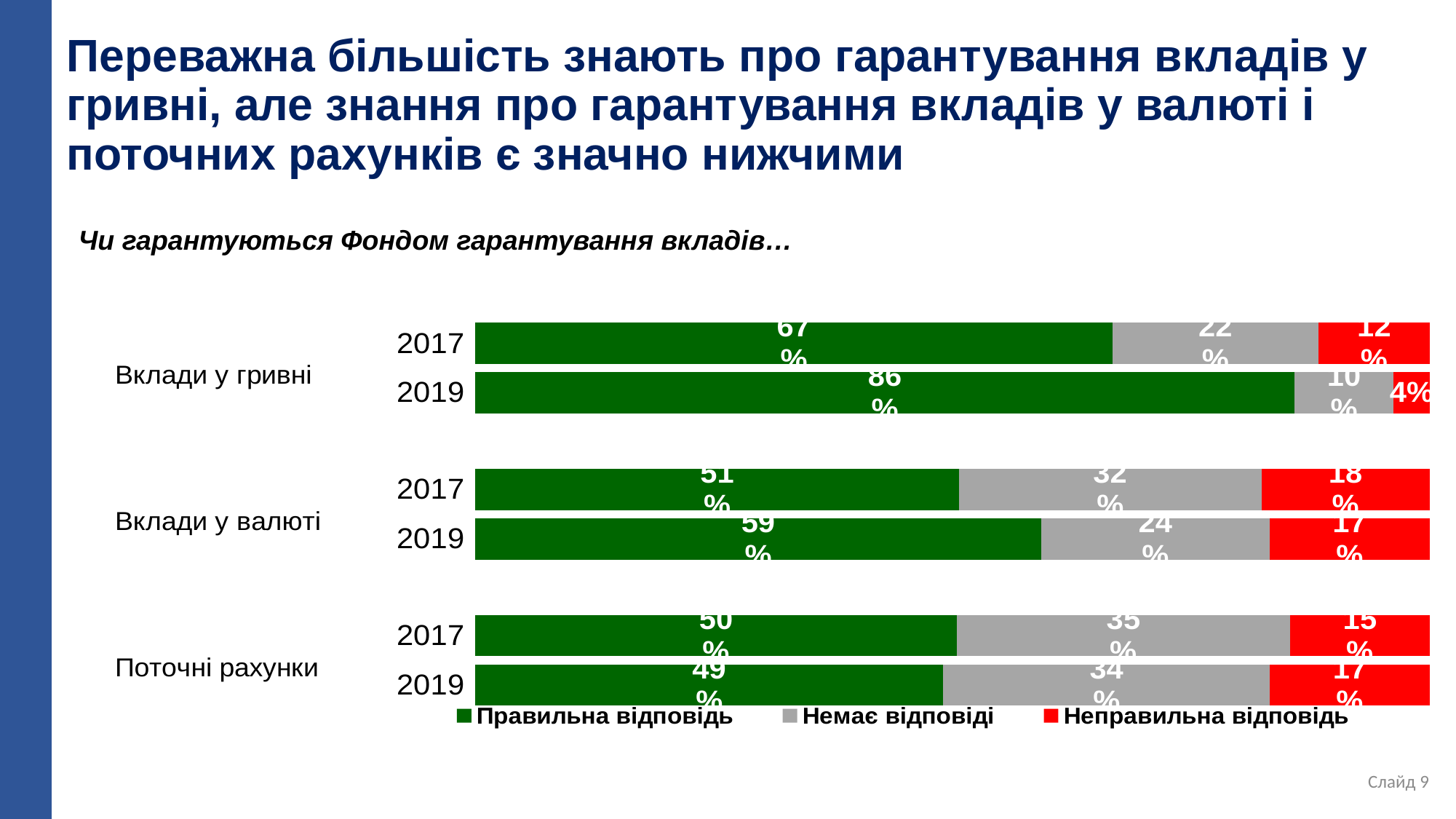
Which bar has the lowest share of correct answers (Правильна відповідь)? Поточні рахунки, 2019 What share of respondents gave the correct answer (Правильна відповідь) about deposits in hryvnia (Вклади у гривні) in 2019? 86% What share of respondents gave an incorrect answer (Неправильна відповідь) about deposits in hryvnia (Вклади у гривні) in 2019? 4% Which bar has the highest share of correct answers (Правильна відповідь)? Вклади у гривні, 2019 What type of chart is shown on the slide? Stacked bar chart What share of respondents gave the correct answer (Правильна відповідь) about deposits in hryvnia (Вклади у гривні) in 2017? 67% Which colour represents the series Неправильна відповідь in the chart? Red By how many percentage points did the share of correct answers about deposits in hryvnia (Вклади у гривні) change from 2017 to 2019? 19 percentage points What share of respondents gave no answer (Немає відповіді) about current accounts (Поточні рахунки) in 2017? 35% What share of respondents gave an incorrect answer (Неправильна відповідь) about deposits in foreign currency (Вклади у валюті) in 2017? 18% How many series does the legend list? 3 Which is larger: the share of correct answers about deposits in foreign currency (Вклади у валюті) in 2019 or about current accounts (Поточні рахунки) in 2019? Вклади у валюті, 2019